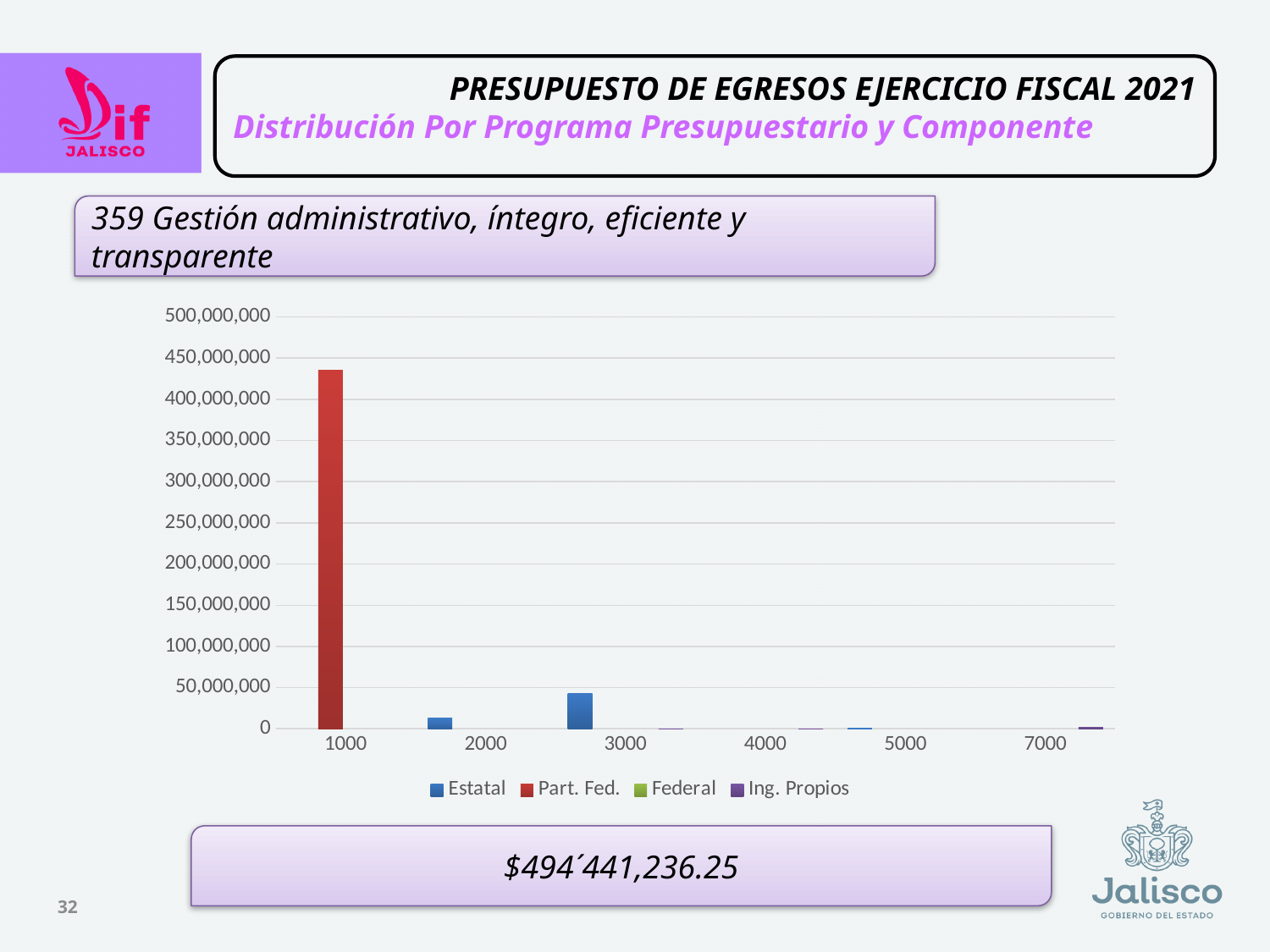
Is the Estatal value for category 3000 greater or less than 50,000,000? less What kind of chart is shown on the slide? Bar chart Which series has the tallest bar in the chart? Part. Fed. Which is larger, the Estatal value for category 3000 or the Estatal value for category 2000? 3000 How many series does the chart legend list? 4 What is the highest value shown on the chart's y axis? 500,000,000 Which is larger, the Part. Fed. value for category 1000 or the Estatal value for category 3000? Part. Fed. for 1000 Is the Part. Fed. value for category 1000 greater or less than 400,000,000? greater Is the Estatal value for category 2000 greater or less than 50,000,000? less How many categories are shown on the x axis of the chart? 6 What colour represents the Part. Fed. series in the chart legend? Red Which category has the tallest bar in the chart? 1000